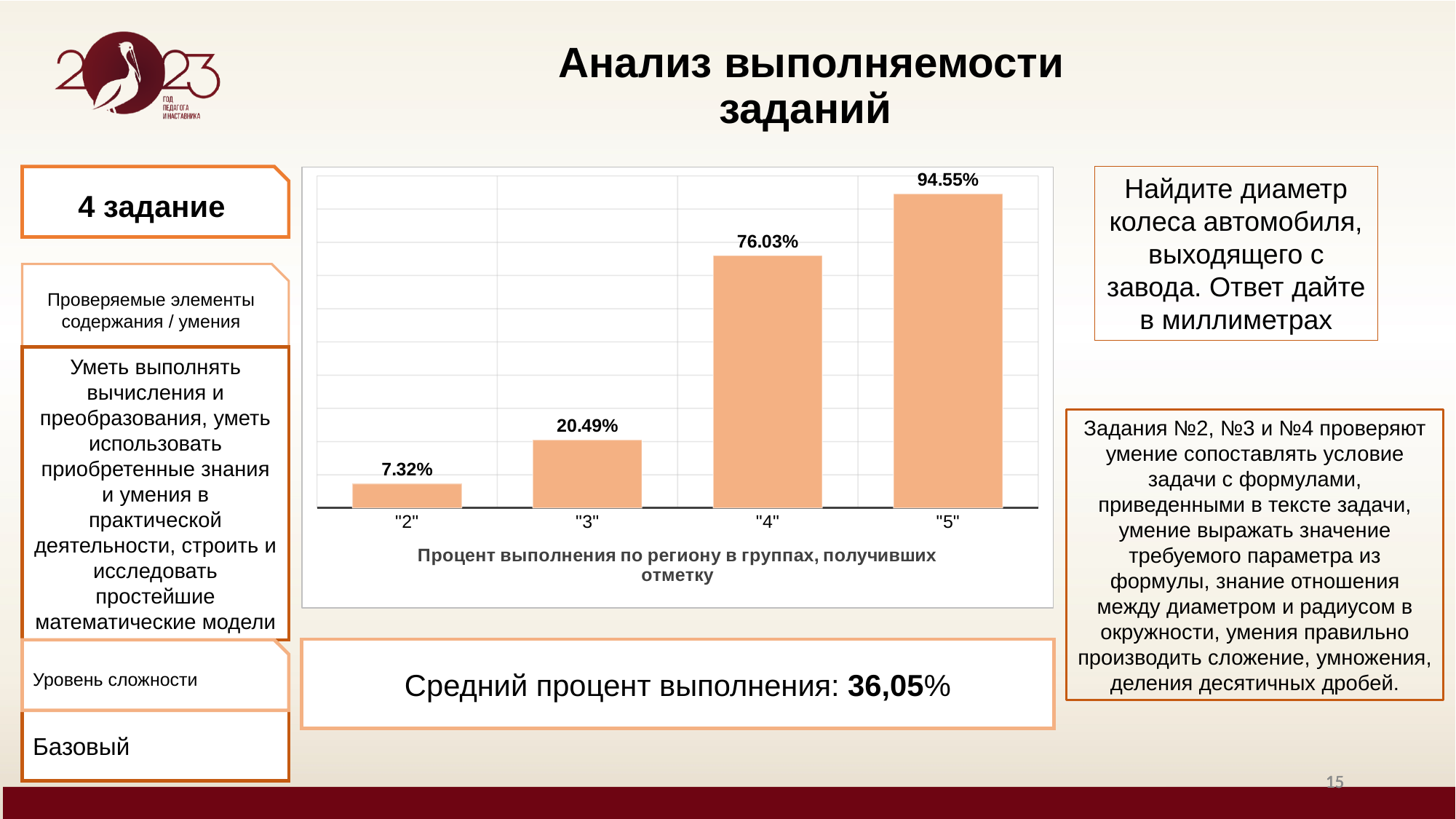
Which group has the highest completion percentage? "5" Do the values rise or fall from the "2" group to the "5" group? Rise How many groups (categories) are shown in the chart? 4 What kind of chart is shown on the slide? Bar chart What is the value for the "2" group in the chart? 7.32% What is the difference between the values for the "3" and "2" groups? 13.17% What is the value for the "4" group in the chart? 76.03% What is the value for the "3" group in the chart? 20.49% Which group has the lowest completion percentage? "2" What is the value for the "5" group in the chart? 94.55% Which is larger, the value for the "3" group or the "4" group? "4" What is the difference between the values for the "5" and "4" groups? 18.52%